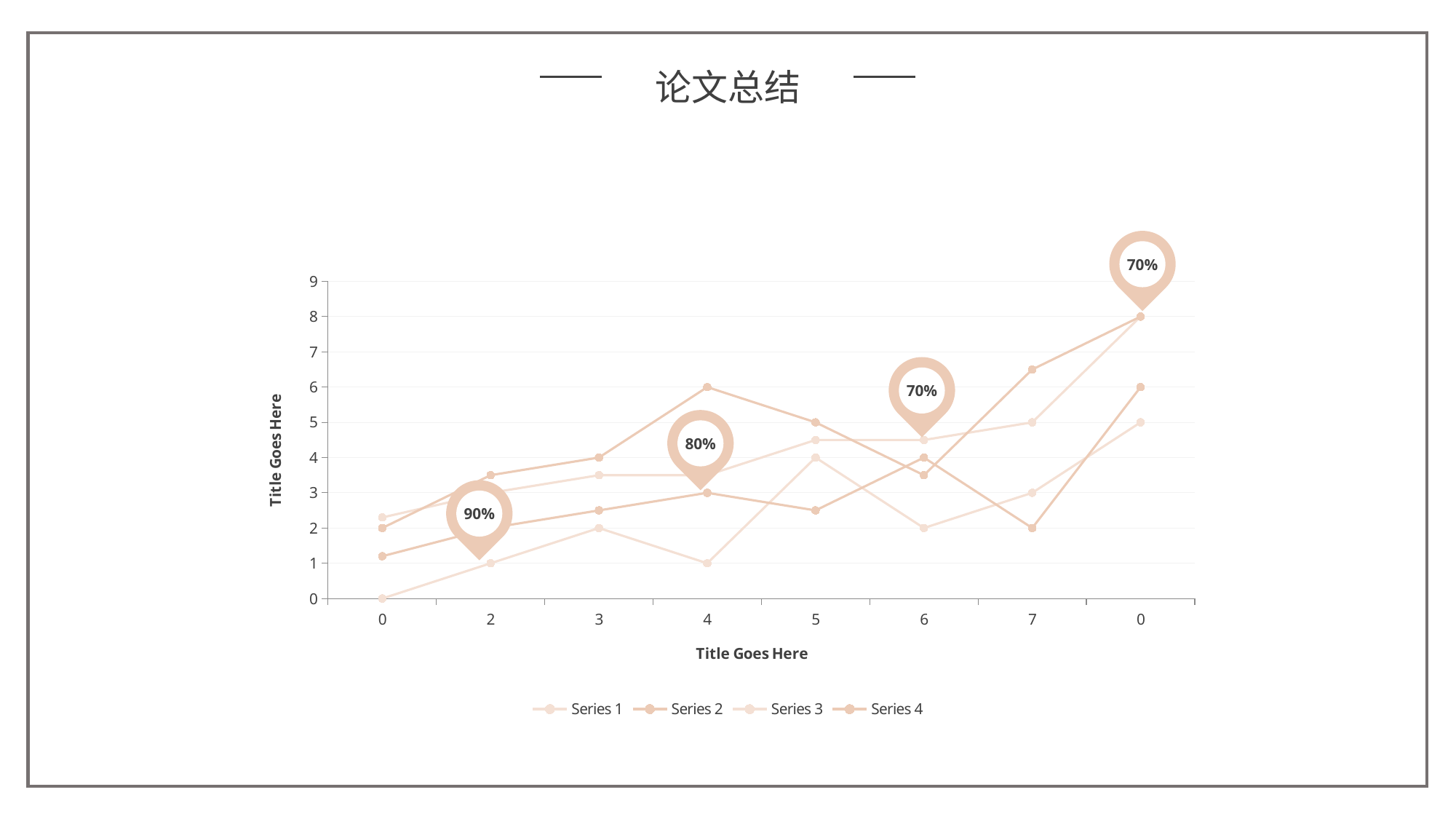
What is the lowest value plotted at category 4? 1 What kind of chart is shown on the slide? line chart What is the lowest value plotted at the first category (0)? 0 How many series does the legend list? 4 What percentage is shown in the callout above category 4? 80% What percentage is shown in the callout above category 2? 90% How many categories are shown along the x axis? 8 What is the title shown on the x axis? Title Goes Here What is the lowest value plotted at category 7? 2 What is the highest value plotted at category 4? 6 What are the series names listed in the legend? Series 1, Series 2, Series 3, Series 4 What is the highest value reached by any series on the chart? 8